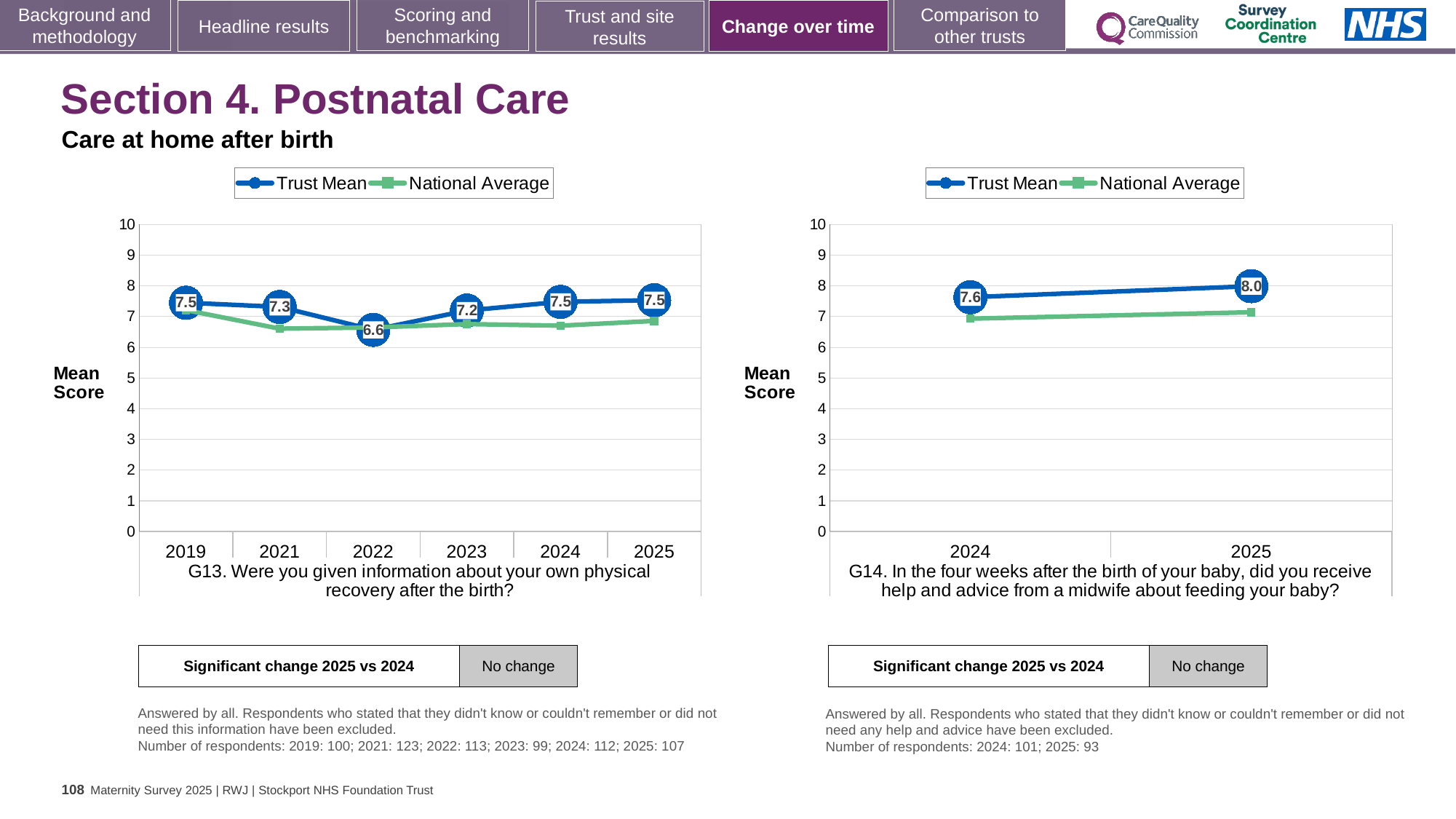
In the left chart (G13), what is the Trust Mean for 2021? 7.3 In the right chart (G14), what is the Trust Mean for 2025? 8.0 In the right chart (G14), what is the difference between the Trust Mean for 2025 and 2024? 0.4 In the left chart (G13), what is the difference between the Trust Mean for 2019 and 2022? 0.9 How many series does the legend of the right chart (G14) list? 2 How many years are shown on the x axis of the left chart (G13)? 6 In the right chart (G14), is the National Average for 2025 greater or less than 8? less What type of chart is the left chart (G13)? line chart In the left chart (G13), is the Trust Mean for 2023 higher or lower than the Trust Mean for 2022? higher In the left chart (G13), which year has the lowest Trust Mean? 2022 In the right chart (G14), does the Trust Mean rise or fall from 2024 to 2025? rise In the left chart (G13), what is the Trust Mean for 2022? 6.6